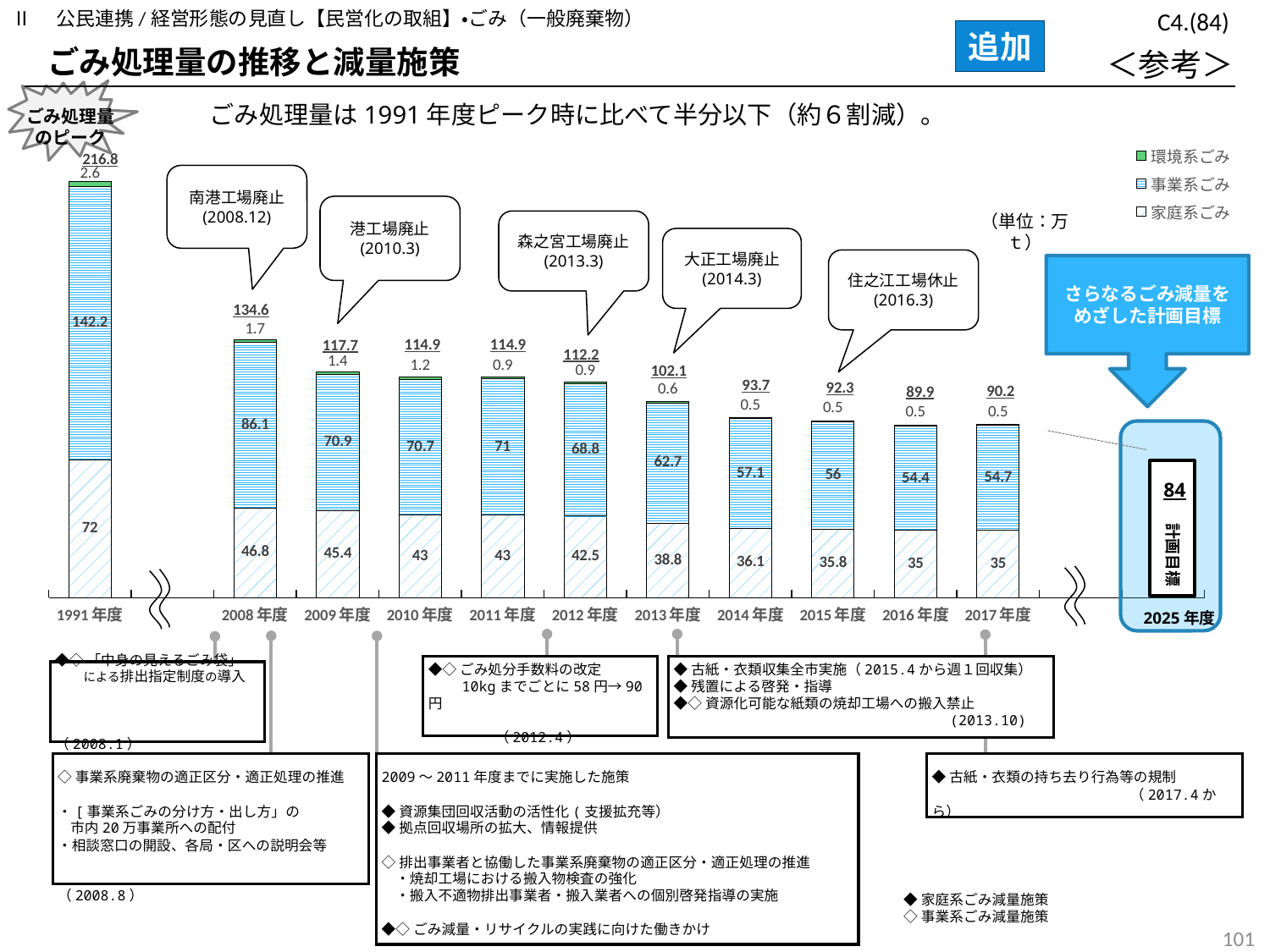
Do the total ごみ処理量 values generally rise or fall from 2008年度 to 2016年度? Fall Which year has the highest total ごみ処理量? 1991年度 What is the 計画目標 value shown for 2025年度? 84 What is the value of 事業系ごみ for 2008年度? 86.1 What type of chart is shown on the slide? Stacked bar chart How many series does the legend list? 3 What is the difference between the total ごみ処理量 for 2008年度 and 2017年度? 44.4 Which year has the lowest value of 家庭系ごみ among the years with printed values? 2016年度 and 2017年度 (35) What is the total ごみ処理量 for 1991年度? 216.8 What is the value of 環境系ごみ for 2010年度? 1.2 What is the value of 家庭系ごみ for 2013年度? 38.8 Which is larger, the 事業系ごみ value for 2014年度 or for 2015年度? 2014年度